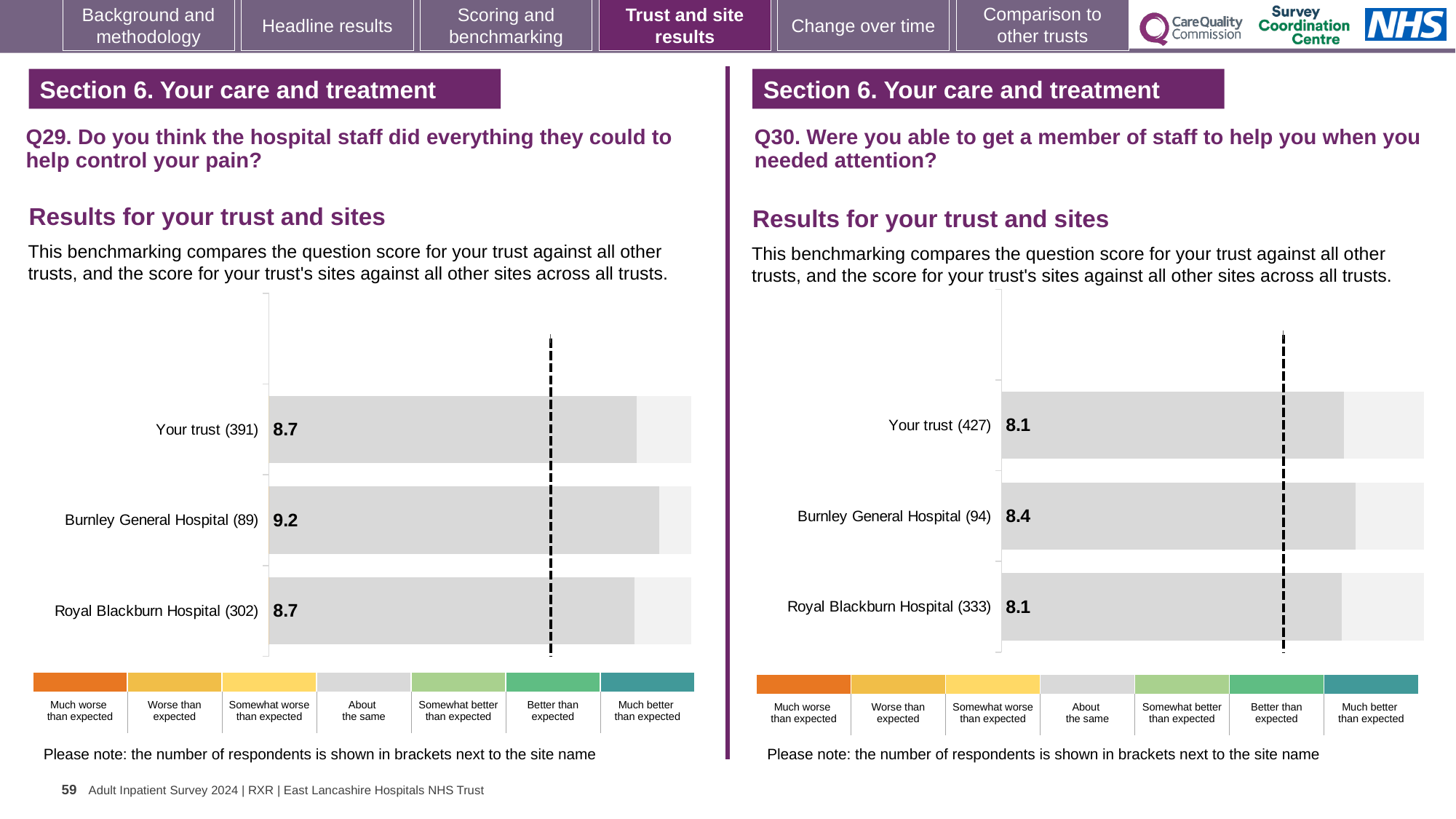
On the Q29 chart (left), what is the difference between the scores for Burnley General Hospital and Royal Blackburn Hospital? 0.5 On the Q30 chart (right), what is the difference between the scores for Burnley General Hospital and Your trust? 0.3 On the Q30 chart (right), which is larger, the score for Burnley General Hospital or the score for Your trust? Burnley General Hospital On the Q29 chart (left), which site or trust has the highest score? Burnley General Hospital On the Q29 chart (left), what is the score for Burnley General Hospital? 9.2 On the Q30 chart (right), what is the score for Royal Blackburn Hospital? 8.1 On the Q29 chart (left), how many respondents are shown in brackets for Royal Blackburn Hospital? 302 On the Q30 chart (right), what is the score for Burnley General Hospital? 8.4 What kind of chart is the Q30 chart (right)? Bar chart On the Q29 chart (left), how many bars are plotted? 3 On the Q29 chart (left), what is the score for Your trust? 8.7 On the Q30 chart (right), how many respondents are shown in brackets for Your trust? 427